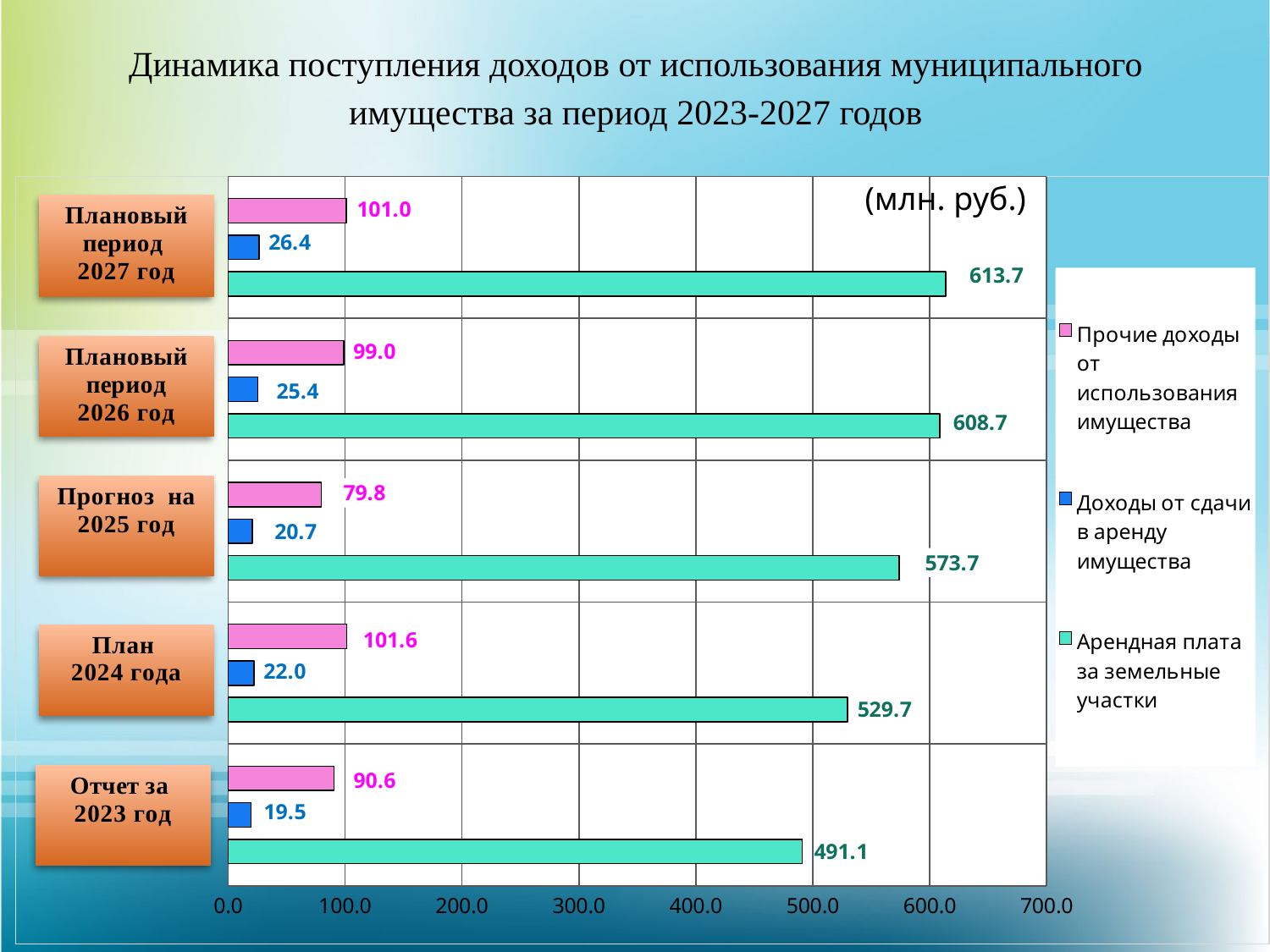
What is the value of 'Арендная плата за земельные участки' for 'Отчет за 2023 год'? 491.1 How many categories (periods) are shown on the chart? 5 What is the value of 'Прочие доходы от использования имущества' for 'Прогноз на 2025 год'? 79.8 Which period has the lowest value for 'Доходы от сдачи в аренду имущества'? Отчет за 2023 год What is the value of 'Доходы от сдачи в аренду имущества' for 'Плановый период 2027 год'? 26.4 Which period has the highest value for 'Арендная плата за земельные участки'? Плановый период 2027 год Does the value of 'Арендная плата за земельные участки' for 'Прогноз на 2025 год' rise or fall compared with 'План 2024 года'? Rise What is the difference between 'Арендная плата за земельные участки' for 'Плановый период 2027 год' and 'Отчет за 2023 год'? 122.6 How many series does the legend list? 3 What type of chart is shown on the slide? Bar chart Which is larger: 'Прочие доходы от использования имущества' for 'План 2024 года' or for 'Плановый период 2027 год'? План 2024 года What unit is indicated on the chart? млн. руб.